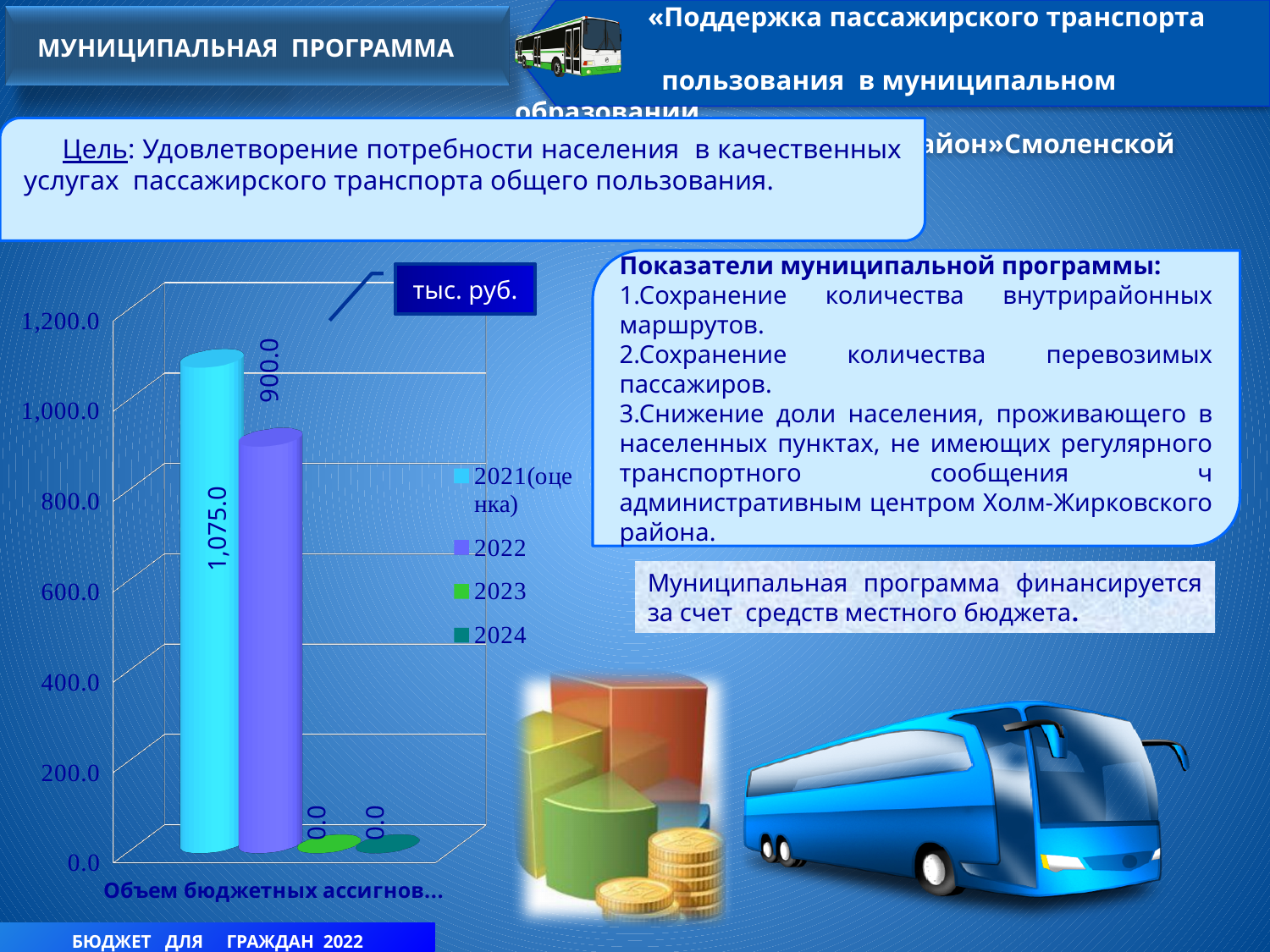
What is the value for the 2021(оценка) series in the chart? 1,075.0 What is the value for the 2024 series in the chart? 0.0 Which series has the highest value in the chart? 2021(оценка) What unit of measurement is shown in the box above the chart? тыс. руб. What is the value for the 2023 series in the chart? 0.0 What kind of chart is shown on the slide? bar chart What is the difference between the 2021(оценка) value and the 2022 value? 175.0 Which is larger, the value for 2021(оценка) or the value for 2022? 2021(оценка) How many series does the chart legend list? 4 What is the value for the 2022 series in the chart? 900.0 Is the value for 2022 greater or less than 1,000.0? less Is the value for 2021(оценка) greater or less than 1,000.0? greater